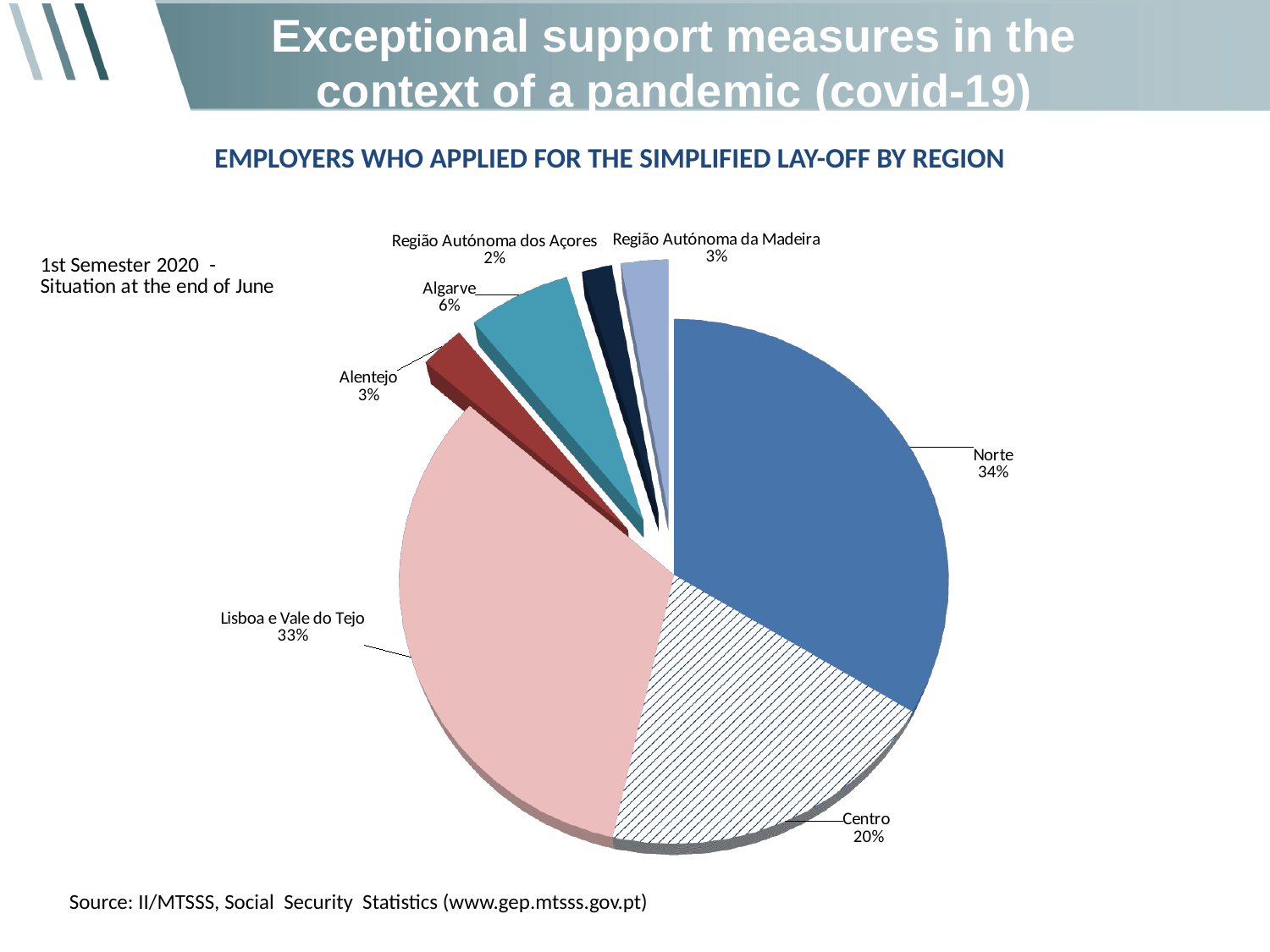
What kind of chart is shown on the slide? Pie chart What percentage is shown for Lisboa e Vale do Tejo? 33% What percentage is shown for Algarve? 6% What is the difference in percentage points between Norte and Centro? 14 How many regions are shown in the pie chart? 7 Which has a larger share, Algarve or Alentejo? Algarve What percentage is shown for the Centro region? 20% What share of employers who applied for the simplified lay-off are in the Norte region? 34% Which region has the largest share of the pie? Norte Which region has the smallest share of the pie? Região Autónoma dos Açores What percentage is shown for Região Autónoma dos Açores? 2% What is the title of the chart? Employers who applied for the simplified lay-off by region